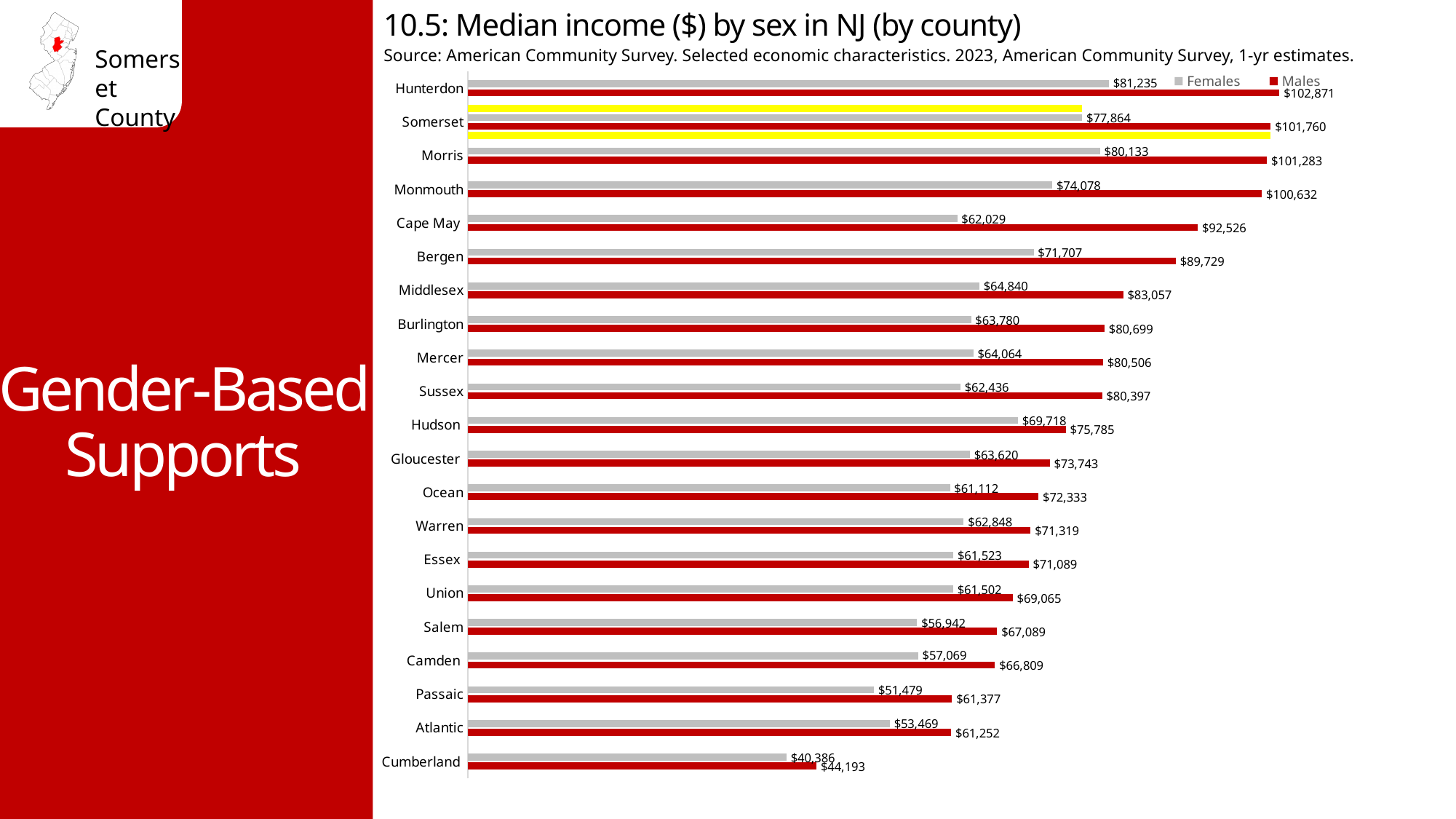
Which county has the highest median income for males? Hunterdon What is the median income for males in Monmouth County? $100,632 How many counties are shown in the chart? 21 What is the median income for females in Somerset County? $77,864 What kind of chart is shown on the slide? Bar chart What is the median income for males in Cumberland County? $44,193 Which is larger, the female median income in Bergen or in Hudson? Bergen What is the difference between male and female median income in Cumberland County? $3,807 What is the difference between male and female median income in Somerset County? $23,896 Which colour represents Males in the chart? Red How many series does the legend list? 2 Which county has the lowest median income for females? Cumberland